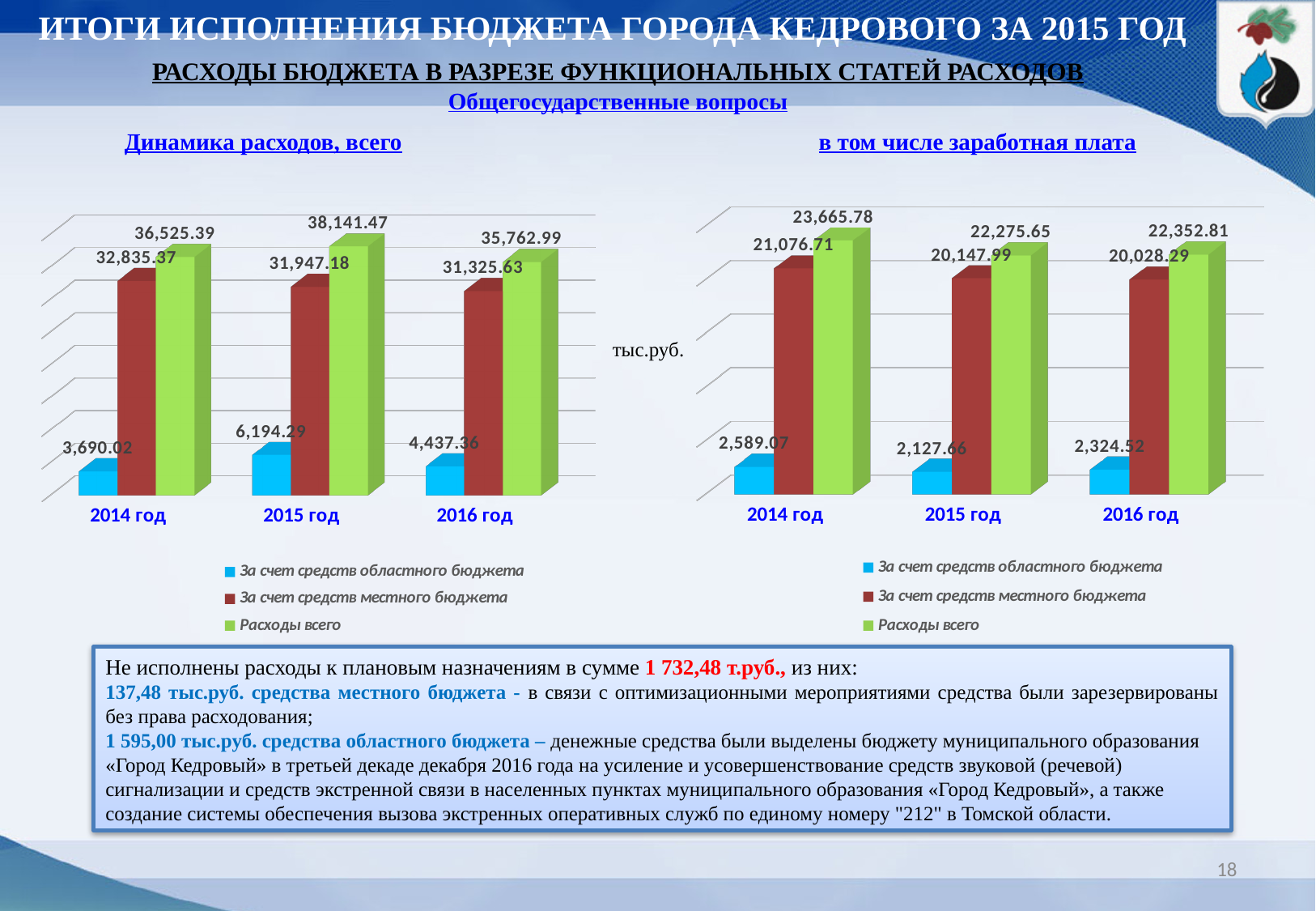
On the right chart (в том числе заработная плата), what is the difference between Расходы всего in 2014 год and 2015 год? 1,390.13 On the left chart (Динамика расходов, всего), what is the value of Расходы всего for 2015 год? 38,141.47 On the left chart (Динамика расходов, всего), which year has the highest Расходы всего? 2015 год On the left chart (Динамика расходов, всего), which is larger: За счет средств областного бюджета in 2015 год or in 2016 год? 2015 год On the left chart (Динамика расходов, всего), what is the value for За счет средств областного бюджета in 2014 год? 3,690.02 On the right chart (в том числе заработная плата), does За счет средств местного бюджета rise or fall from 2014 год to 2016 год? Fall On the left chart (Динамика расходов, всего), what is the difference between Расходы всего in 2015 год and 2014 год? 1,616.08 On the right chart (в том числе заработная плата), which year has the lowest value for За счет средств областного бюджета? 2015 год On the right chart (в том числе заработная плата), what is the value for За счет средств местного бюджета in 2016 год? 20,028.29 How many series does the legend of the right chart (в том числе заработная плата) list? 3 What type of chart is the left chart (Динамика расходов, всего)? Bar chart On the right chart (в том числе заработная плата), what is the value of Расходы всего for 2014 год? 23,665.78